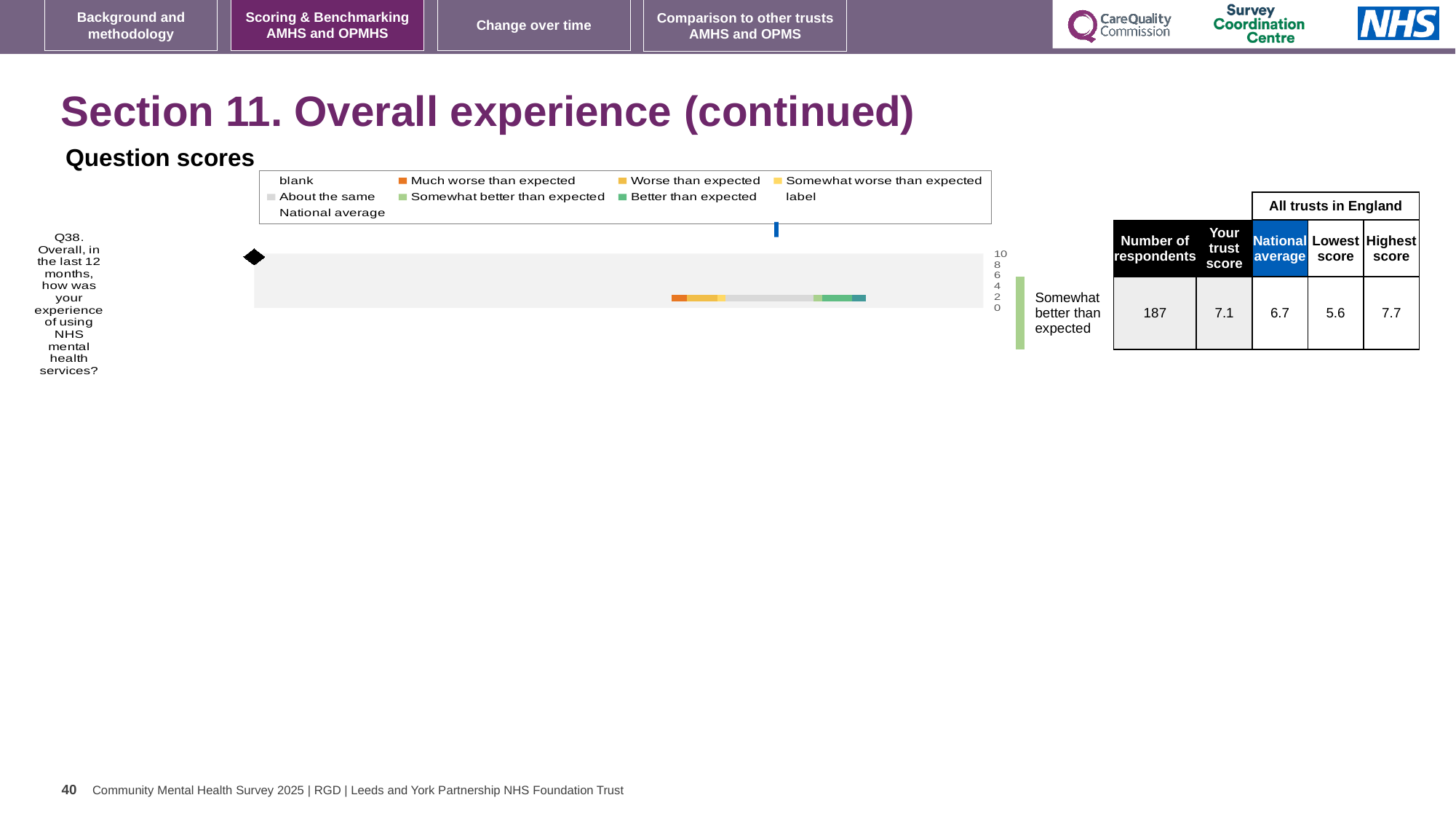
What is the lowest score among all trusts in England for Q38? 5.6 By how much does the trust's Q38 score exceed the national average? 0.4 Which benchmark category is the trust's Q38 score placed in? Somewhat better than expected How many respondents answered Q38? 187 For Q38, which is larger: the trust's score or the national average? The trust's score (7.1) What is the trust's score for Q38 (overall experience of using NHS mental health services)? 7.1 What is the national average score for Q38? 6.7 How many survey questions are plotted in the Question scores chart? 1 What is the difference between the highest and lowest trust scores for Q38? 2.1 Is the trust's score for Q38 greater or less than 6? greater What is the highest score among all trusts in England for Q38? 7.7 What kind of chart is used to show the Q38 question score? Bar chart